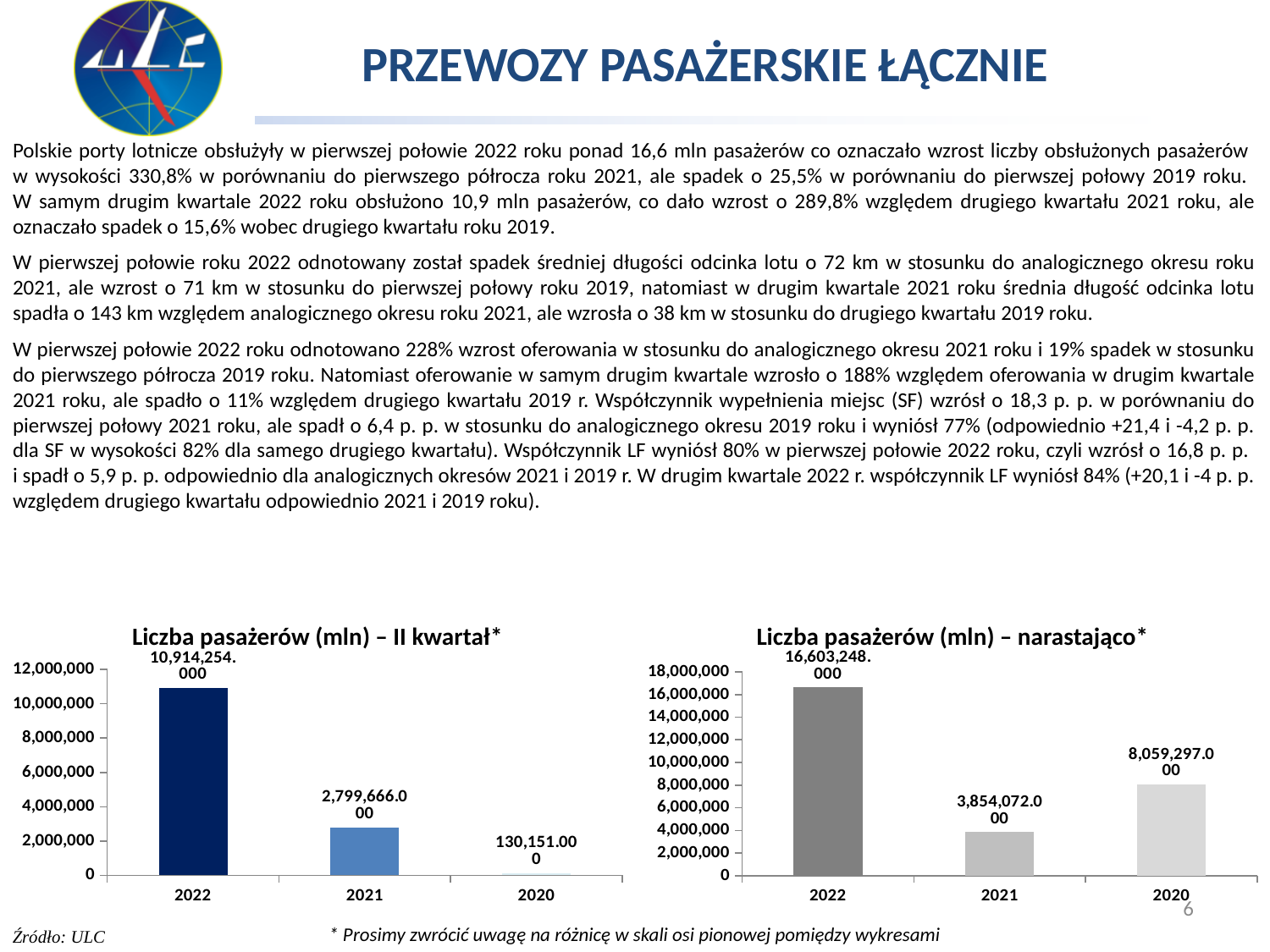
In the chart titled 'Liczba pasażerów (mln) – II kwartał*', what is the difference between the values for 2022 and 2021? 8,114,588.000 In the chart titled 'Liczba pasażerów (mln) – II kwartał*', which year has the lowest value? 2020 In the chart titled 'Liczba pasażerów (mln) – narastająco*', which is larger, the value for 2021 or the value for 2020? 2020 In the chart titled 'Liczba pasażerów (mln) – II kwartał*', is the value for 2021 greater or less than 4,000,000? less In the chart titled 'Liczba pasażerów (mln) – narastająco*', what is the value for 2020? 8,059,297.000 In the chart titled 'Liczba pasażerów (mln) – narastająco*', which year has the highest value? 2022 In the chart titled 'Liczba pasażerów (mln) – narastająco*', what is the value for 2021? 3,854,072.000 In the chart titled 'Liczba pasażerów (mln) – narastająco*', what is the difference between the values for 2020 and 2021? 4,205,225.000 In the chart titled 'Liczba pasażerów (mln) – II kwartał*', what is the value for 2020? 130,151.000 What kind of chart is the chart titled 'Liczba pasażerów (mln) – II kwartał*'? bar chart In the chart titled 'Liczba pasażerów (mln) – II kwartał*', what is the value for 2022? 10,914,254.000 How many years are shown on the x axis of the chart titled 'Liczba pasażerów (mln) – narastająco*'? 3